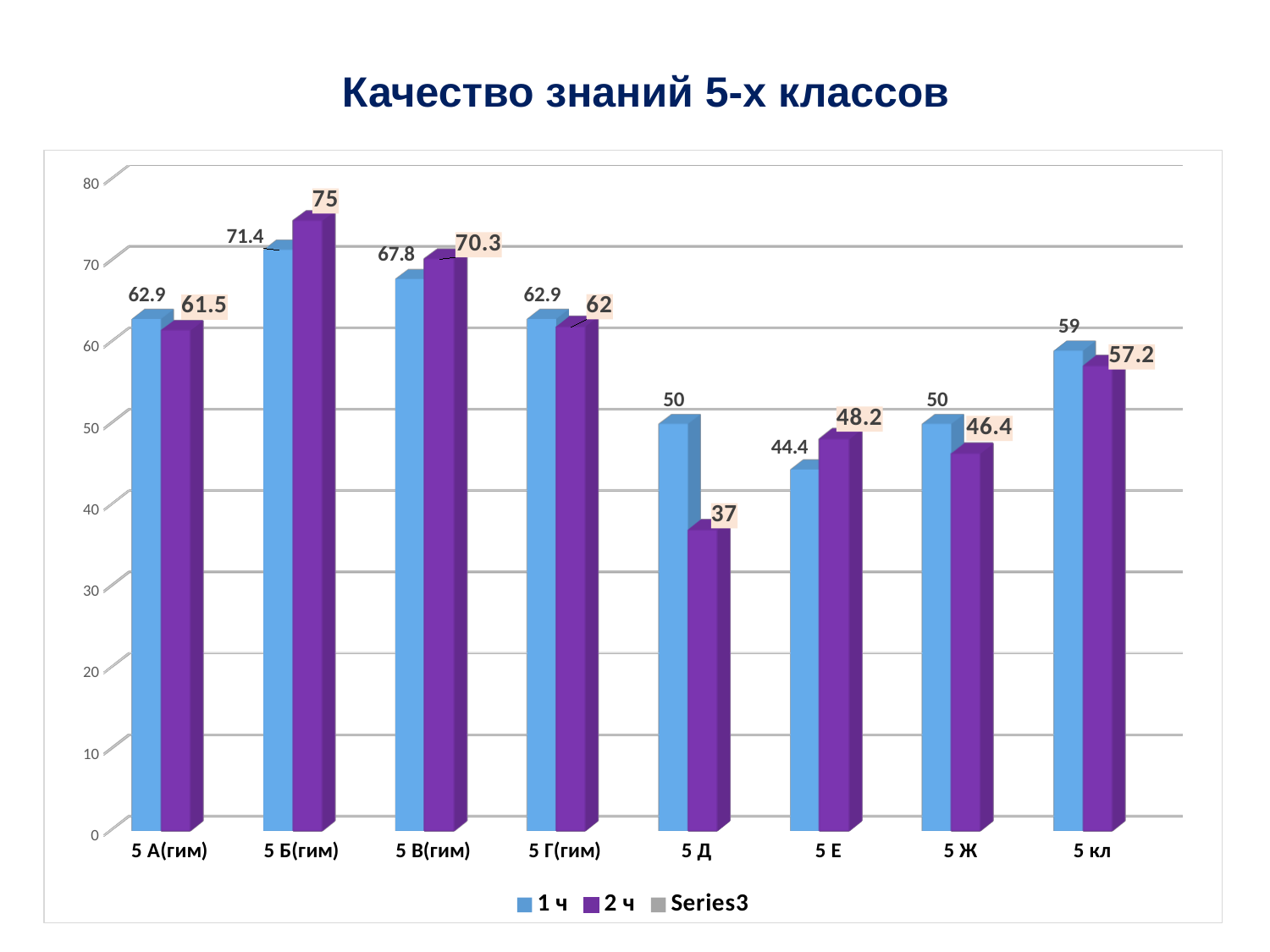
What is the value for 5 Д in the 2 ч series? 37 Which category has the lowest value in the 1 ч series? 5 Е What is the value for 5 Е in the 2 ч series? 48.2 How many categories are shown on the x axis? 8 What kind of chart is shown on the slide? bar chart What is the title of the chart? Качество знаний 5-х классов How many series does the legend list? 3 What is the difference between the 1 ч and 2 ч values for 5 Д? 13 Which is larger for 5 Ж: the 1 ч value or the 2 ч value? 1 ч Which category has the highest value in the 2 ч series? 5 Б(гим) What is the value for 5 Б(гим) in the 1 ч series? 71.4 What is the difference between the 2 ч values for 5 Б(гим) and 5 В(гим)? 4.7